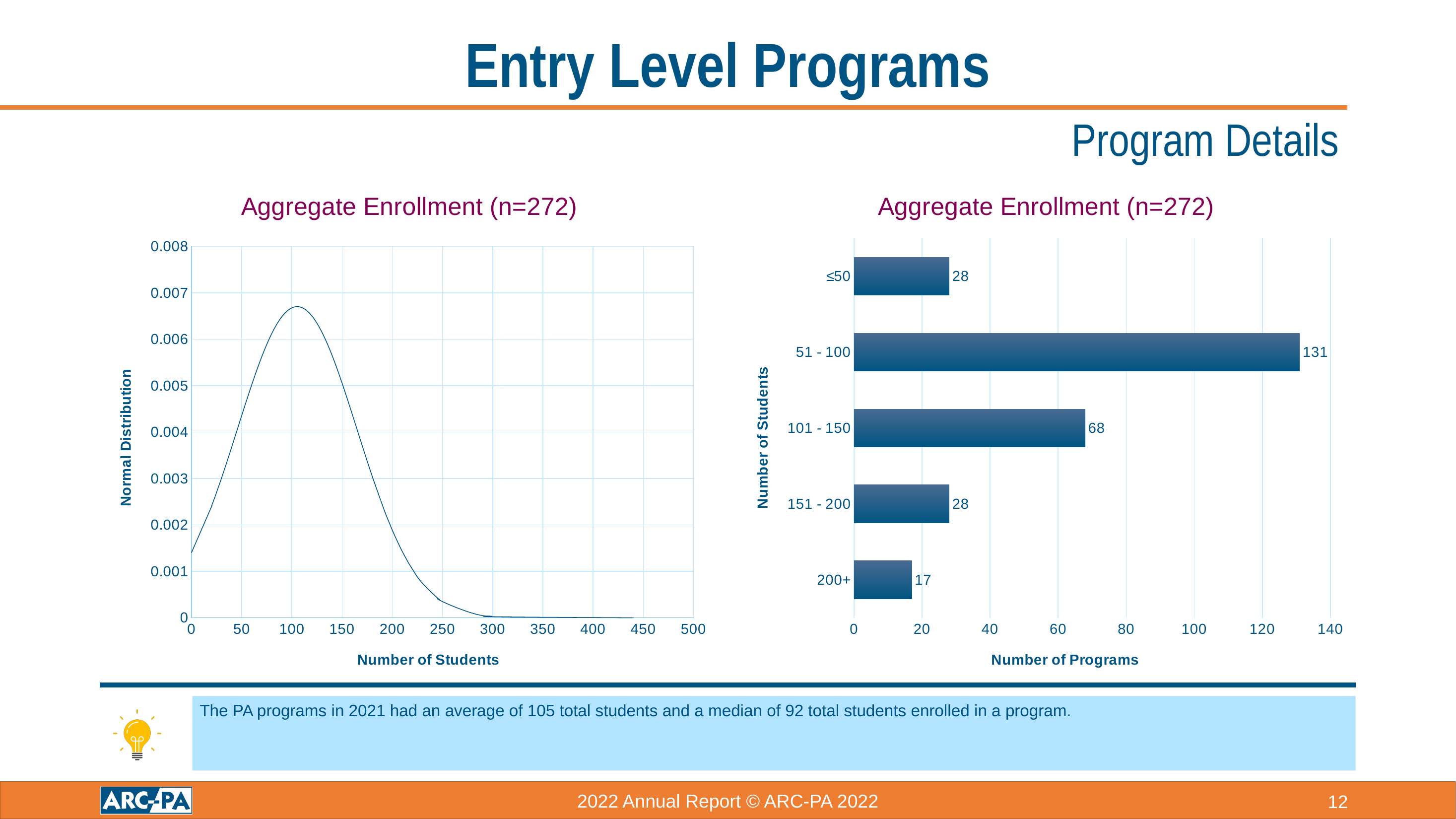
In the bar chart on the right, which enrollment category has the fewest programs? 200+ How many enrollment categories are shown in the bar chart on the right? 5 What is the x-axis label of the chart on the left? Number of Students In the line chart on the left, is the peak value of the curve greater or less than 0.006? greater What kind of chart is the chart on the right side of the slide? Bar chart In the bar chart on the right, how many programs have 101 - 150 students? 68 In the bar chart on the right, how many programs have 51 - 100 students? 131 What kind of chart is the chart on the left side of the slide? Line chart In the bar chart on the right, how many programs have 200+ students? 17 In the bar chart on the right, which has more programs: 101 - 150 students or 151 - 200 students? 101 - 150 In the bar chart on the right, what is the difference between the number of programs with 51 - 100 students and the number with 101 - 150 students? 63 In the bar chart on the right, which enrollment category has the most programs? 51 - 100